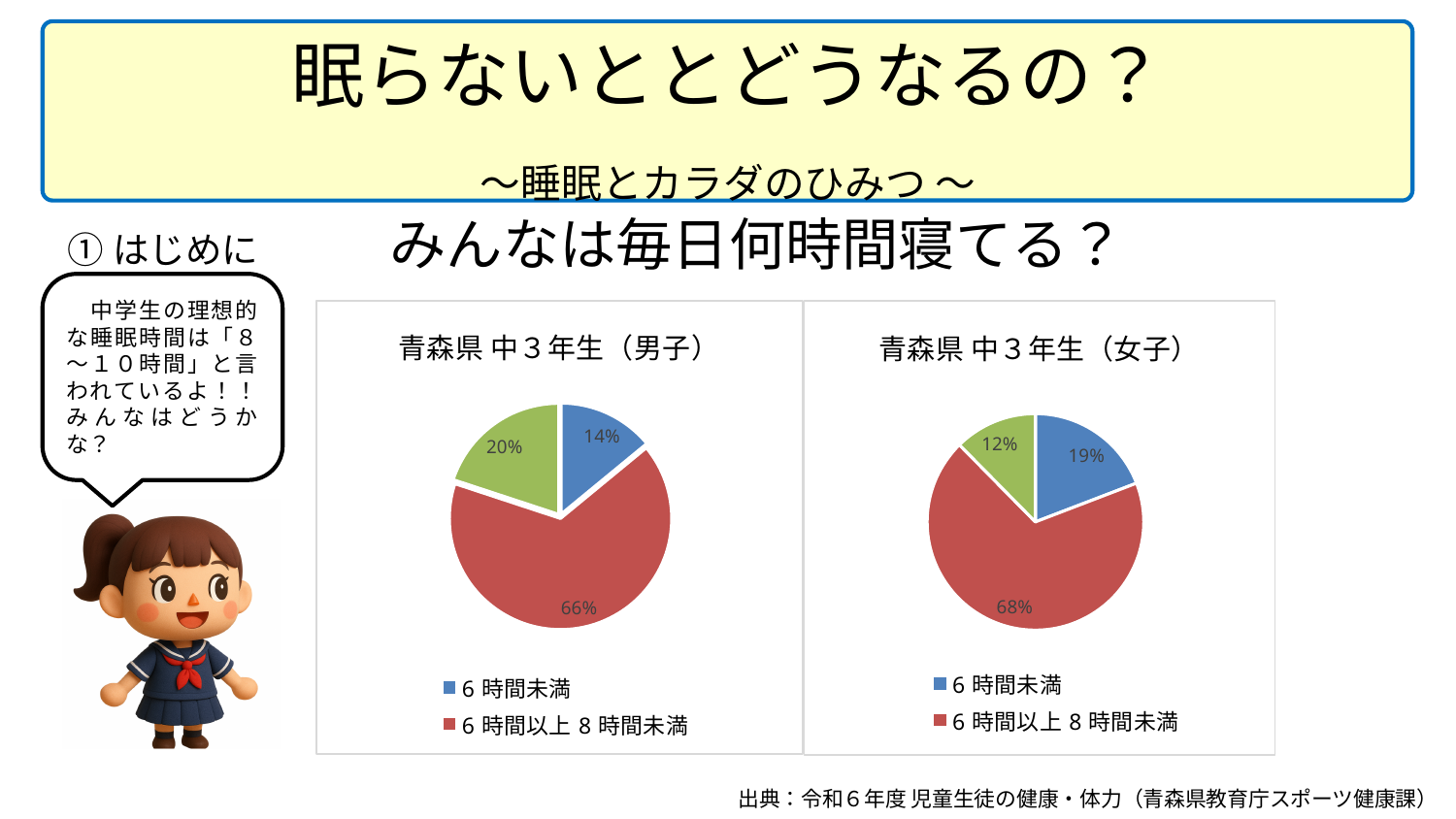
Which chart shows a higher percentage for 6 時間未満, the 男子 chart or the 女子 chart? 女子 In the 青森県 中３年生（女子） chart, how many percentage points larger is 6 時間以上 8 時間未満 than 6 時間未満? 49 percentage points In the 青森県 中３年生（男子） chart, which category has the largest slice? 6 時間以上 8 時間未満 In the 青森県 中３年生（男子） chart, what percentage is shown for 6 時間未満? 14% In the 青森県 中３年生（男子） chart, how many percentage points larger is 6 時間以上 8 時間未満 than 6 時間未満? 52 percentage points In the 青森県 中３年生（男子） chart, what colour represents 6 時間未満? Blue In the 青森県 中３年生（男子） chart, what percentage is shown for 6 時間以上 8 時間未満? 66% In the 青森県 中３年生（女子） chart, what percentage is shown for 6 時間以上 8 時間未満? 68% What kind of chart is used for the 青森県 中３年生（男子） data? Pie chart How many slices does the 青森県 中３年生（女子） pie chart have? 3 In the 青森県 中３年生（女子） chart, what is the smallest percentage shown on any slice? 12% In the 青森県 中３年生（女子） chart, what percentage is shown for 6 時間未満? 19%